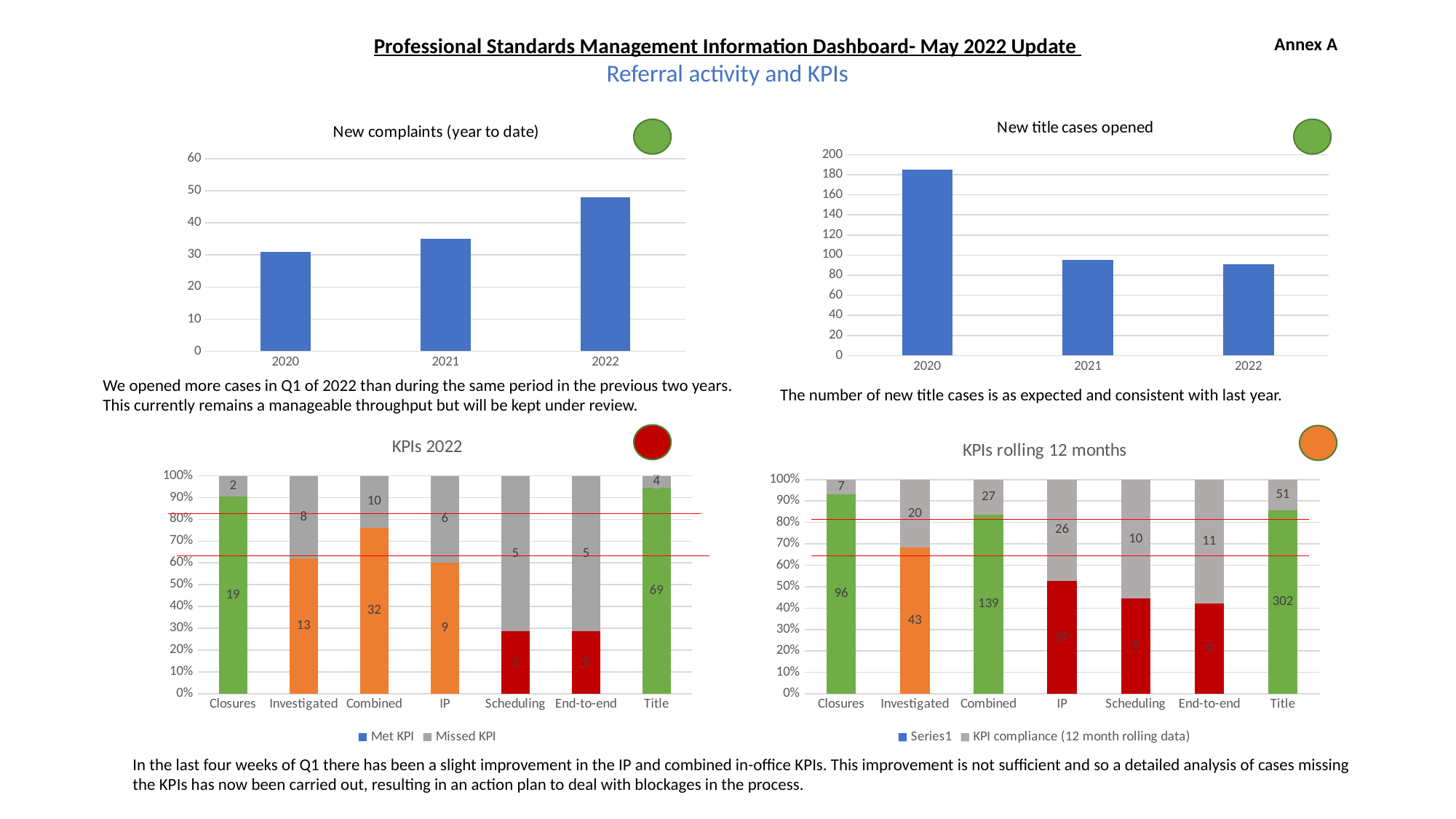
In the 'New title cases opened' chart, which year has the highest value? 2020 How many years are shown in the 'New title cases opened' chart? 3 In the 'New complaints (year to date)' chart, which year has the highest bar? 2022 In the 'New title cases opened' chart, is the value for 2021 greater or less than 100? less In the 'New complaints (year to date)' chart, do the values rise or fall from 2020 to 2022? rise In the 'KPIs 2022' chart, what is the Met KPI value for Title? 69 In the 'KPIs 2022' chart, what is the total of the Closures bar (Met KPI plus Missed KPI)? 21 In the 'New complaints (year to date)' chart, is the value for 2022 greater or less than 40? greater What kind of chart is 'KPIs 2022'? Stacked bar chart In the 'KPIs rolling 12 months' chart, what is the grey segment value for Title? 51 In the 'KPIs 2022' chart, what is the Missed KPI value for Combined? 10 In the 'KPIs rolling 12 months' chart, what is the lower segment value for Combined? 139